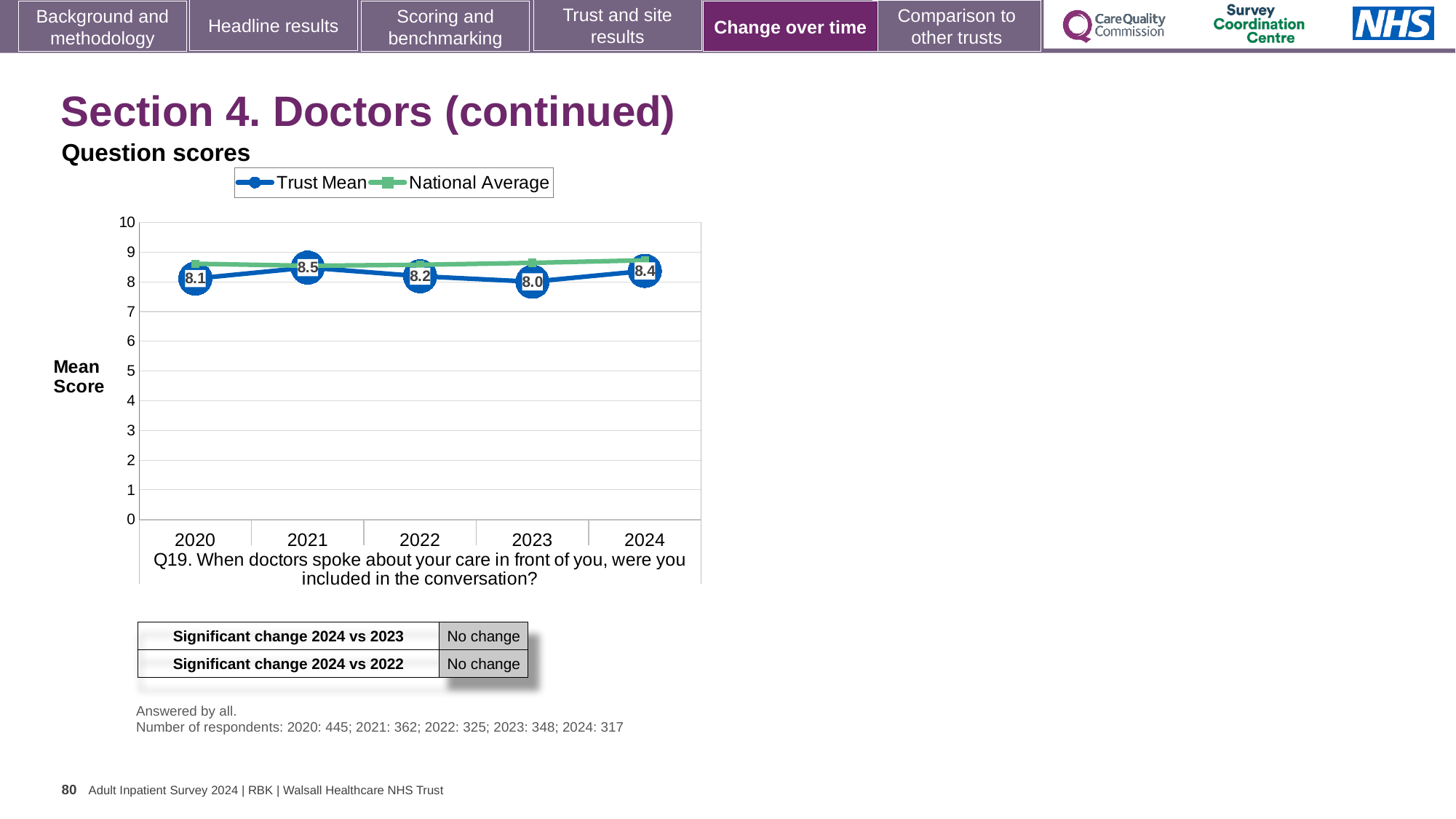
What is the Trust Mean score for 2024? 8.4 In which year is the Trust Mean lowest? 2023 What kind of chart is shown? line chart How many series does the legend list? 2 How many years are plotted on the x axis? 5 What is the Trust Mean score for 2023? 8.0 What is the Trust Mean score for 2021? 8.5 Does the Trust Mean rise or fall from 2023 to 2024? rise Which year has the larger Trust Mean, 2020 or 2022? 2022 In which year is the Trust Mean highest? 2021 Is the National Average value for 2024 greater or less than 8? greater What is the difference between the Trust Mean in 2021 and in 2023? 0.5